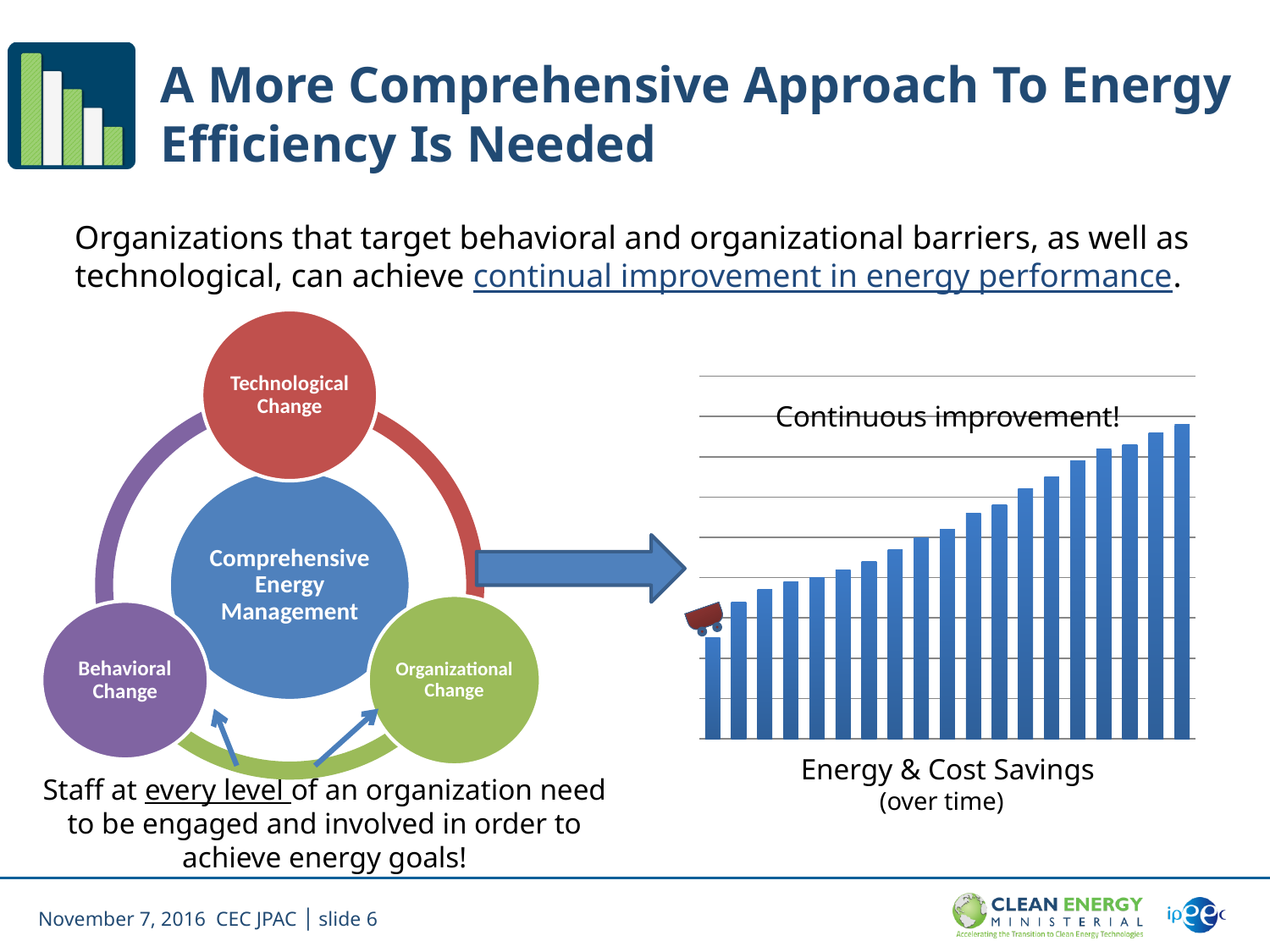
Which bar in the chart is the shortest? the leftmost bar Do the bar heights in the chart rise or fall from left to right? rise Is the leftmost bar or the rightmost bar taller in the chart? the rightmost bar What text appears as the title above the bars in the chart? Continuous improvement! Which bar in the chart is the tallest? the rightmost bar What label appears below the chart's horizontal axis? Energy & Cost Savings (over time) What kind of chart is shown on the right side of the slide? bar chart